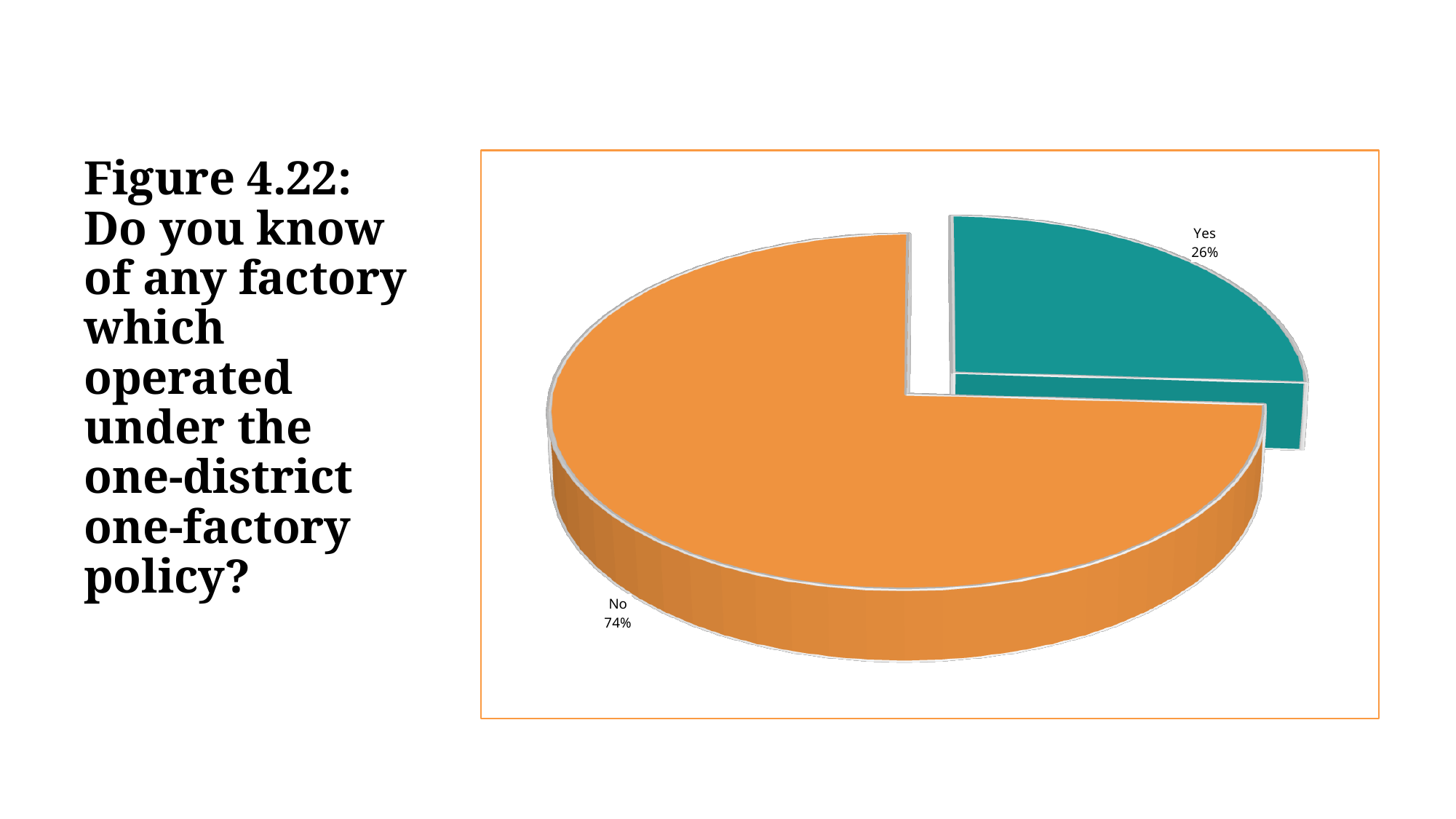
Which response has the largest share of the pie? No What colour is the "No" slice? Orange How many slices does the pie chart have? 2 What percentage of respondents answered "Yes"? 26% What is the figure number given in the slide title? Figure 4.22 Which is larger, the "Yes" slice or the "No" slice? No What kind of chart is shown on the slide? Pie chart What percentage of respondents answered "No"? 74% What share of the pie does the "Yes" slice represent? 26% Which response has the smallest share of the pie? Yes What is the difference in percentage points between the "No" and "Yes" slices? 48